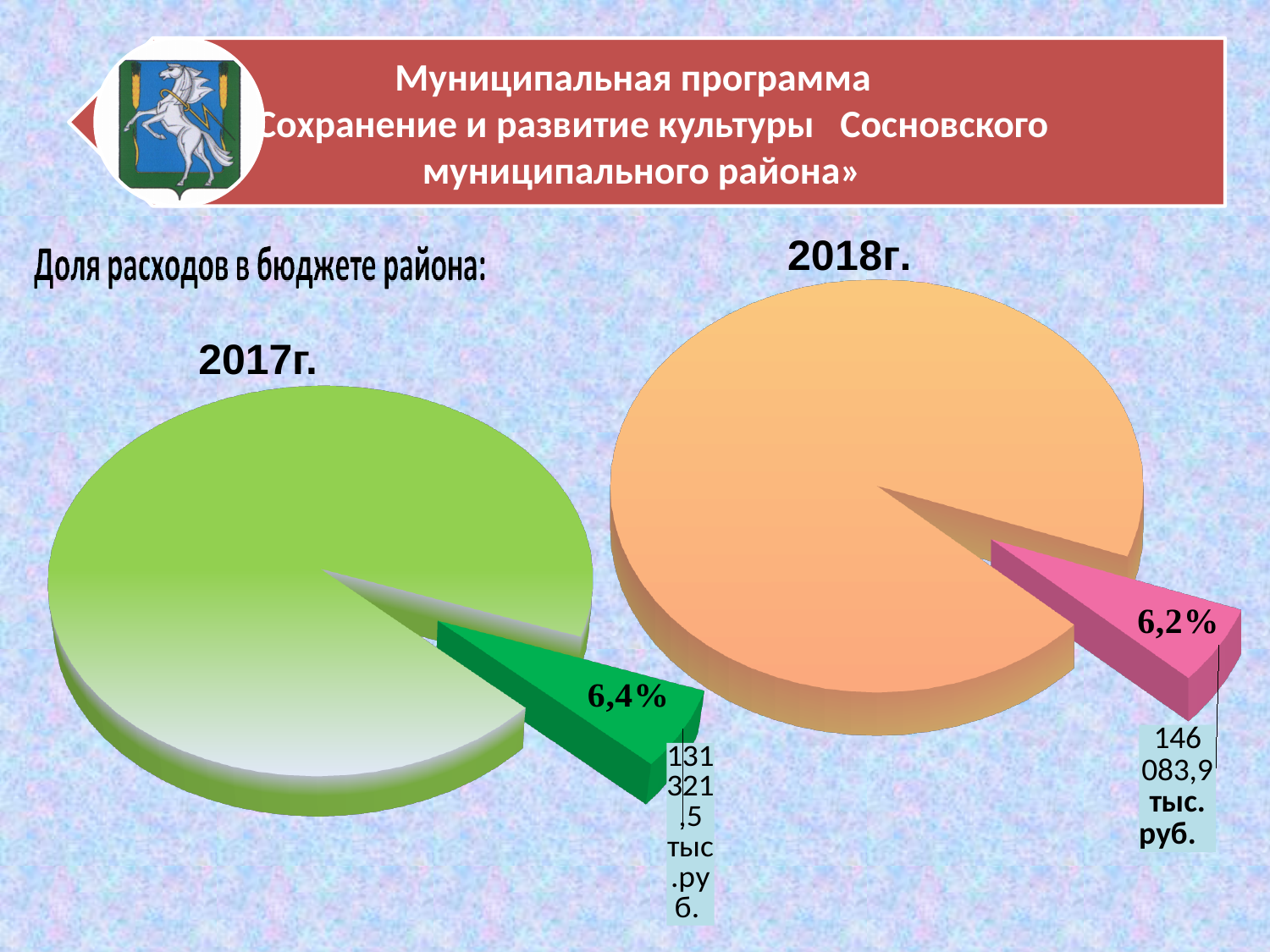
How many pie charts are shown on the slide? 2 What amount in thousand roubles is labelled on the 2018г. pie chart slice? 146 083,9 тыс. руб. What kind of chart is used for the 2017г. data? pie chart Does the share of the culture programme in the district budget rise or fall from 2017г. to 2018г.? fall Which year's pie chart shows the larger share for the culture programme, 2017г. or 2018г.? 2017г. What colour is the highlighted slice in the 2018г. pie chart? pink What amount in thousand roubles is labelled on the 2017г. pie chart slice? 131 321,5 тыс.руб. By how many percentage points does the 2017г. share (6,4%) exceed the 2018г. share (6,2%)? 0,2 What colour is the highlighted slice in the 2017г. pie chart? green In the 2017г. pie chart, what share of the district budget is shown for the culture programme slice? 6,4% Is the share shown in the 2018г. pie chart greater or less than 10%? less In the 2018г. pie chart, what share of the district budget is shown for the culture programme slice? 6,2%